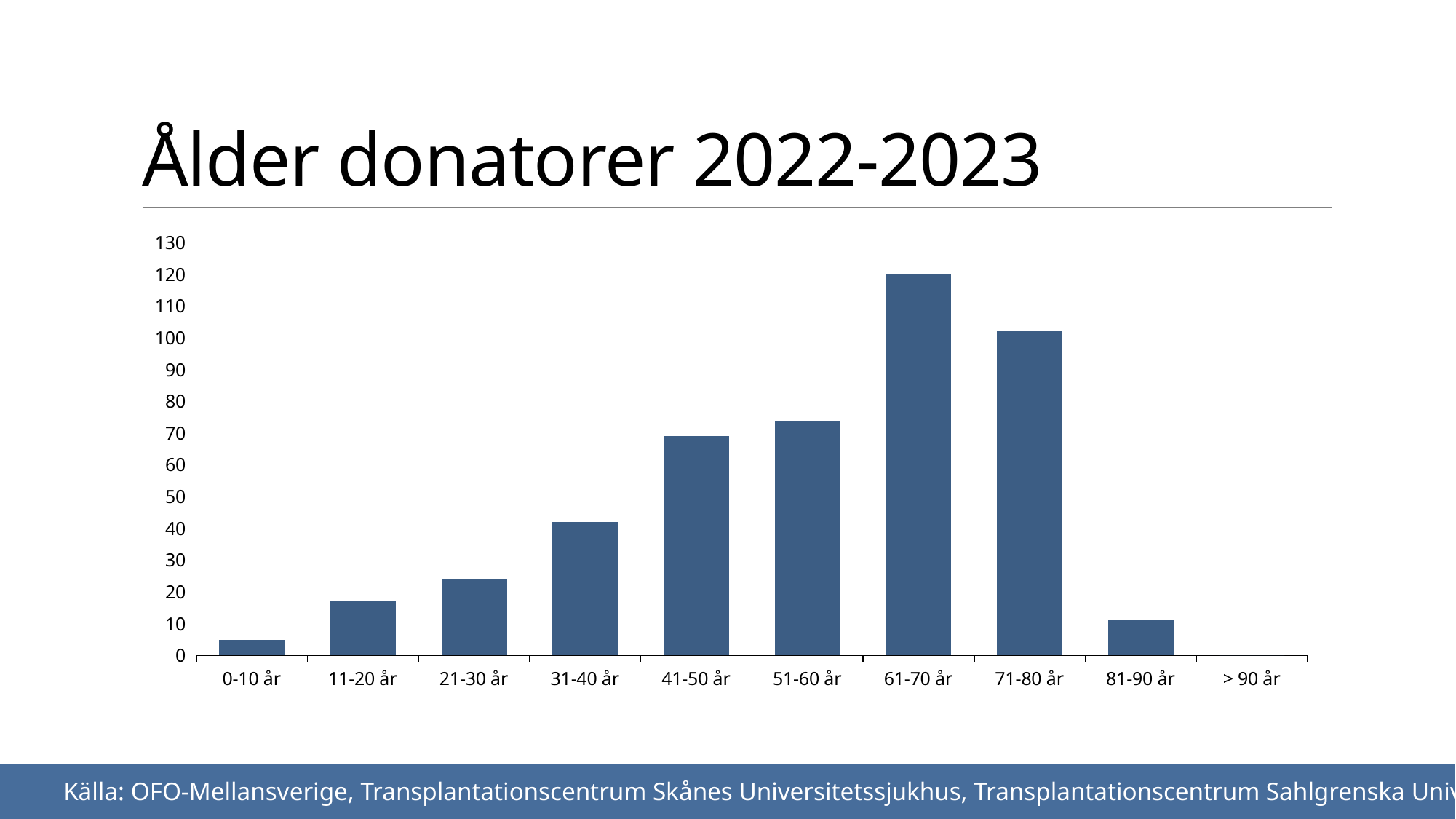
Which has the larger value, 61-70 år or 71-80 år? 61-70 år Is the value for 71-80 år greater or less than 90? greater Which age category has the highest value? 61-70 år Is the value for 41-50 år greater or less than 60? greater Which age category has the lowest value? > 90 år Is the value for 81-90 år greater or less than 20? less What kind of chart is shown on the slide? Bar chart Do the values rise or fall from 0-10 år to 61-70 år? rise How many age categories are shown on the x axis? 10 What is the value for the 61-70 år category? 120 What is the title of the chart? Ålder donatorer 2022-2023